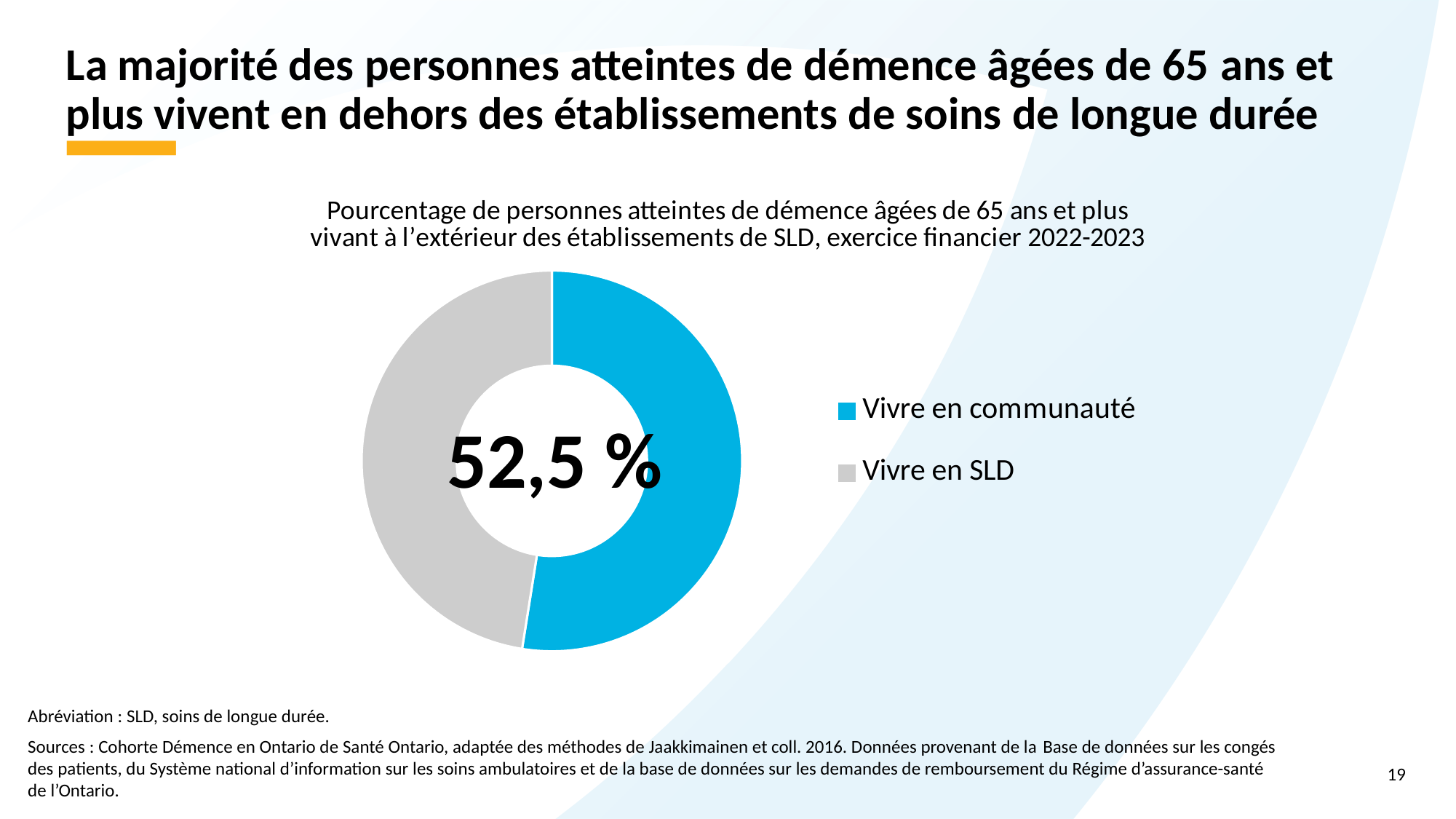
What colour is used for "Vivre en SLD" in the chart? grey Which category has the largest slice? Vivre en communauté How many entries does the legend list? 2 Which is larger, the slice for "Vivre en communauté" or the slice for "Vivre en SLD"? Vivre en communauté Is the value for "Vivre en communauté" greater or less than 50 %? greater Which category has the smallest slice? Vivre en SLD How many slices does the chart have? 2 What share of the pie does "Vivre en communauté" represent? 52,5 % What kind of chart is shown on the slide? pie chart (donut) What percentage is shown for "Vivre en communauté"? 52,5 % Which fiscal year does the chart title say the data covers? 2022-2023